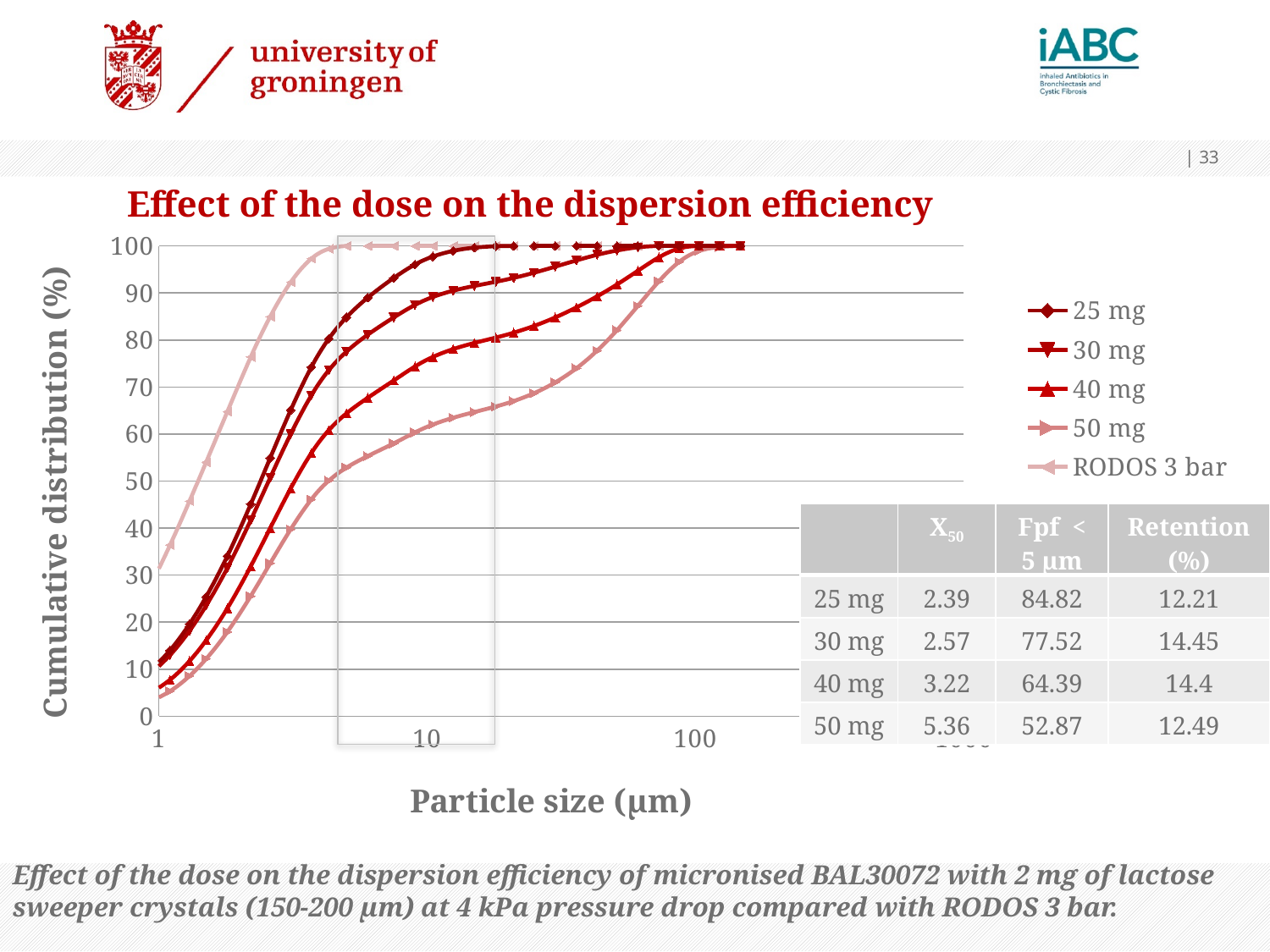
Which series reaches 100% cumulative distribution at the smallest particle size? RODOS 3 bar At a particle size of 10 µm, is the value for 25 mg greater or less than 90? greater At a particle size of 10 µm, is the value for 50 mg greater or less than 70? less What kind of chart is shown on the slide? line chart At a particle size of 10 µm, which is larger, the value for 25 mg or the value for 50 mg? 25 mg What is the title of the chart? Effect of the dose on the dispersion efficiency At a particle size of 1 µm, is the value for 50 mg greater or less than 10? less Do the cumulative distribution values rise or fall as particle size increases along the x axis? rise What is the label of the x axis of the chart? Particle size (µm) At a particle size of 10 µm, which series has the lowest cumulative distribution? 50 mg How many series does the chart legend list? 5